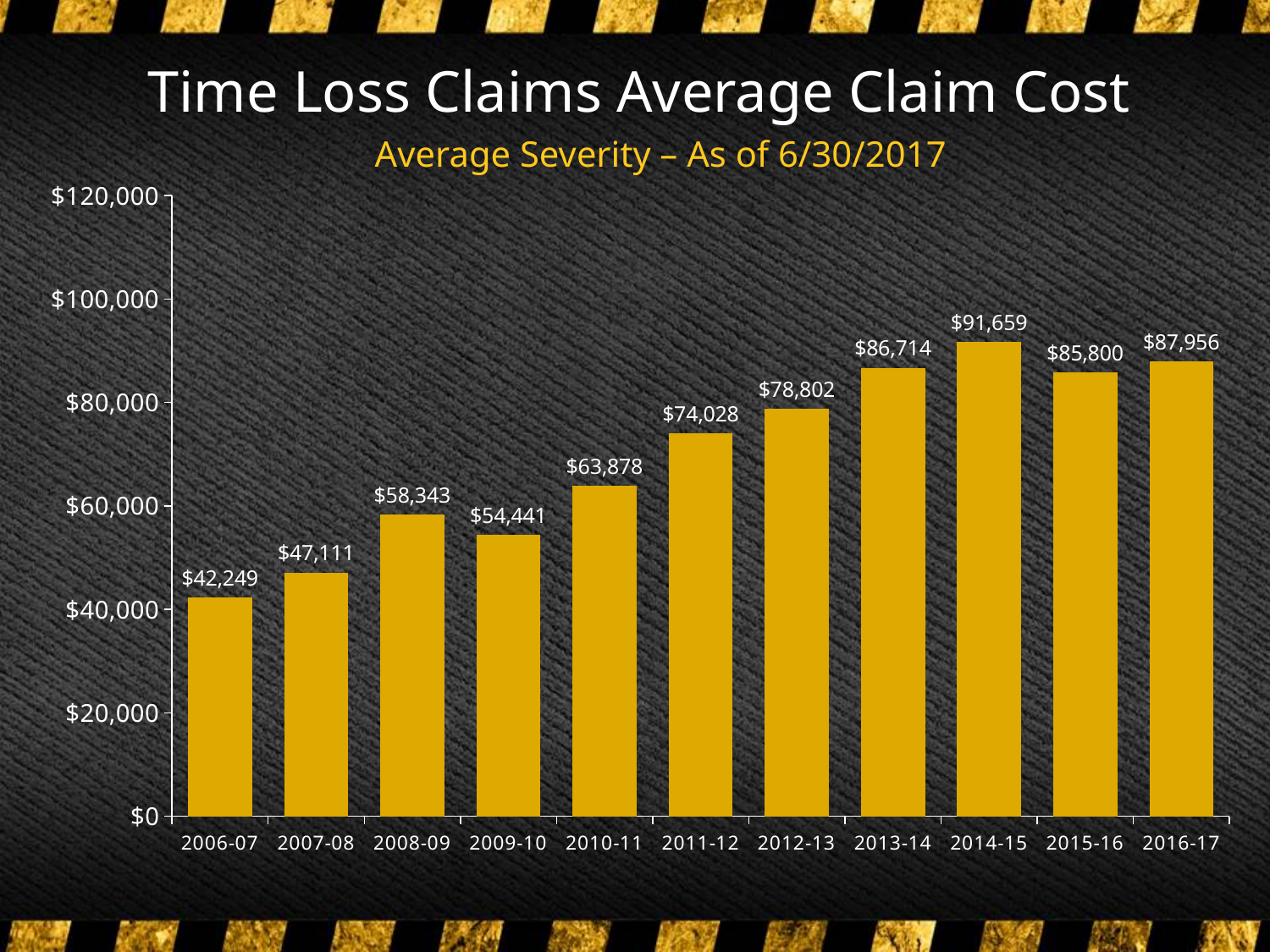
What is the average claim cost for 2006-07? $42,249 Is the average claim cost for 2012-13 greater or less than $80,000? less What is the average claim cost for 2015-16? $85,800 What is the average claim cost for 2010-11? $63,878 Which year has the highest average claim cost? 2014-15 Which year has a higher average claim cost, 2008-09 or 2009-10? 2008-09 What is the difference between the average claim cost in 2014-15 and in 2006-07? $49,410 How many fiscal years are shown on the chart? 11 How much higher is the average claim cost in 2016-17 than in 2015-16? $2,156 Which year has the lowest average claim cost? 2006-07 Do the average claim costs generally rise or fall from 2006-07 to 2016-17? rise What type of chart is shown on the slide? bar chart